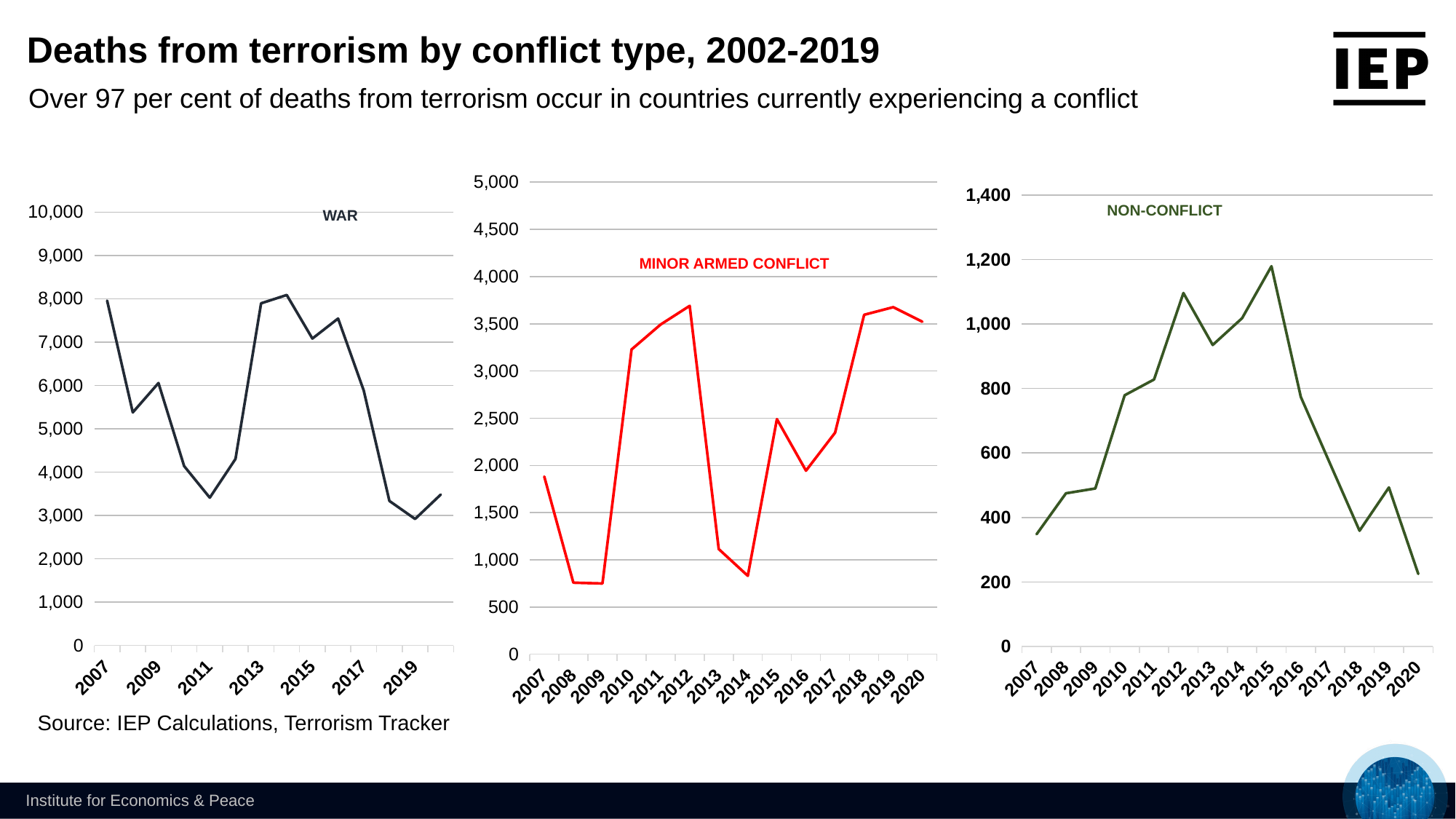
On the NON-CONFLICT chart, which year has the highest value? 2015 On the WAR chart, is the value for 2011 greater or less than 4,000? less On the WAR chart, is the value for 2007 greater or less than 7,000? greater What kind of chart is the WAR chart? line chart On the NON-CONFLICT chart, how many years are plotted along the x axis? 14 On the MINOR ARMED CONFLICT chart, is the value for 2012 greater or less than 3,000? greater On the NON-CONFLICT chart, which year has the lowest value? 2020 On the WAR chart, which year has the larger value, 2014 or 2008? 2014 On the NON-CONFLICT chart, which year has the larger value, 2012 or 2013? 2012 On the NON-CONFLICT chart, do values rise or fall from 2015 to 2020? fall What colour is the line on the MINOR ARMED CONFLICT chart? red